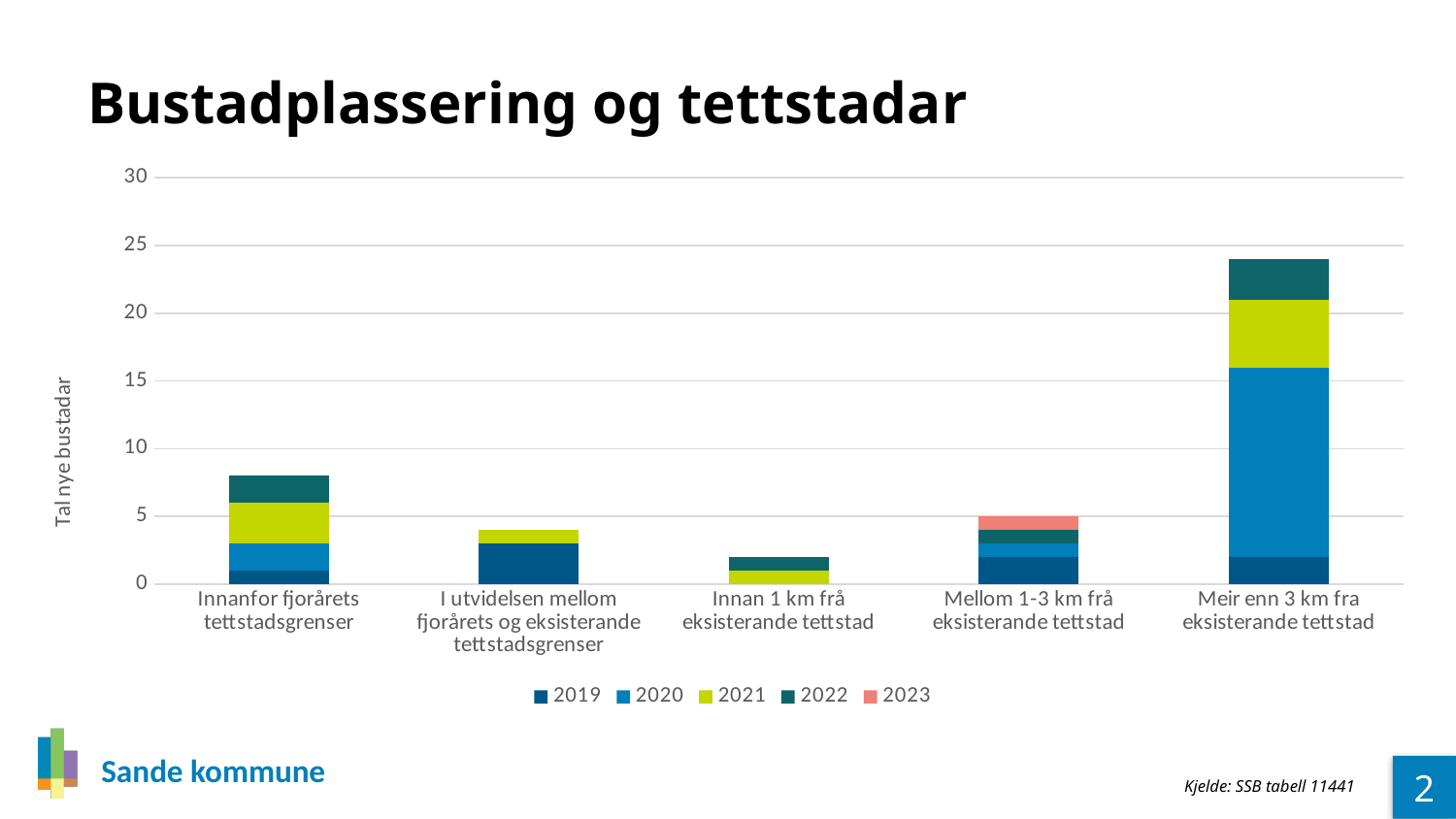
Which stacked bar is taller: 'I utvidelsen mellom fjorårets og eksisterande tettstadsgrenser' or 'Meir enn 3 km fra eksisterande tettstad'? Meir enn 3 km fra eksisterande tettstad What kind of chart is shown on the slide? stacked bar chart What is the title of the chart on the slide? Bustadplassering og tettstadar Which category has the tallest stacked bar? Meir enn 3 km fra eksisterande tettstad Is the total stacked value for 'Innanfor fjorårets tettstadsgrenser' greater or less than 10? less Which category has the shortest stacked bar? Innan 1 km frå eksisterande tettstad How many categories are shown on the x axis of the chart? 5 What is the label of the y axis of the chart? Tal nye bustadar Which stacked bar is taller: 'Innanfor fjorårets tettstadsgrenser' or 'Mellom 1-3 km frå eksisterande tettstad'? Innanfor fjorårets tettstadsgrenser How many series does the legend of the chart list? 5 Is the total stacked value for 'Meir enn 3 km fra eksisterande tettstad' greater or less than 20? greater Is the total stacked value for 'Mellom 1-3 km frå eksisterande tettstad' greater or less than 10? less